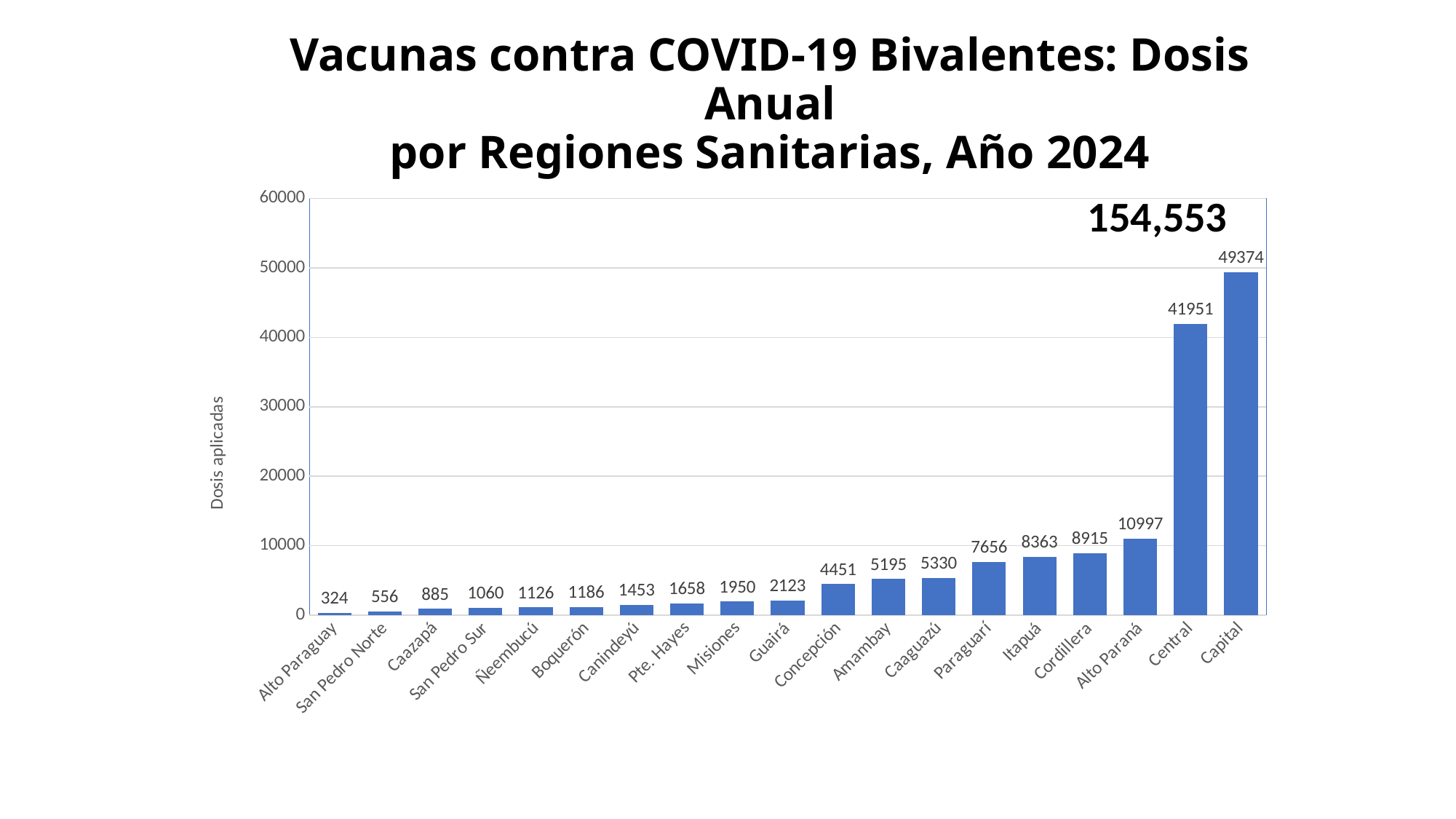
Which region has the lowest number of doses applied? Alto Paraguay What is the value shown for Concepción? 4451 What is the difference between the values for Capital and Central? 7423 Which region has the highest number of doses applied? Capital What is the label of the vertical axis? Dosis aplicadas Is the value for Central greater or less than 40000? greater Which has a larger value, Itapuá or Paraguarí? Itapuá How many regions are shown on the x axis? 19 What is the value shown for Alto Paraguay? 324 What kind of chart is shown on the slide? bar chart What is the difference between the values for Alto Paraná and Cordillera? 2082 How many doses were applied in Central? 41951